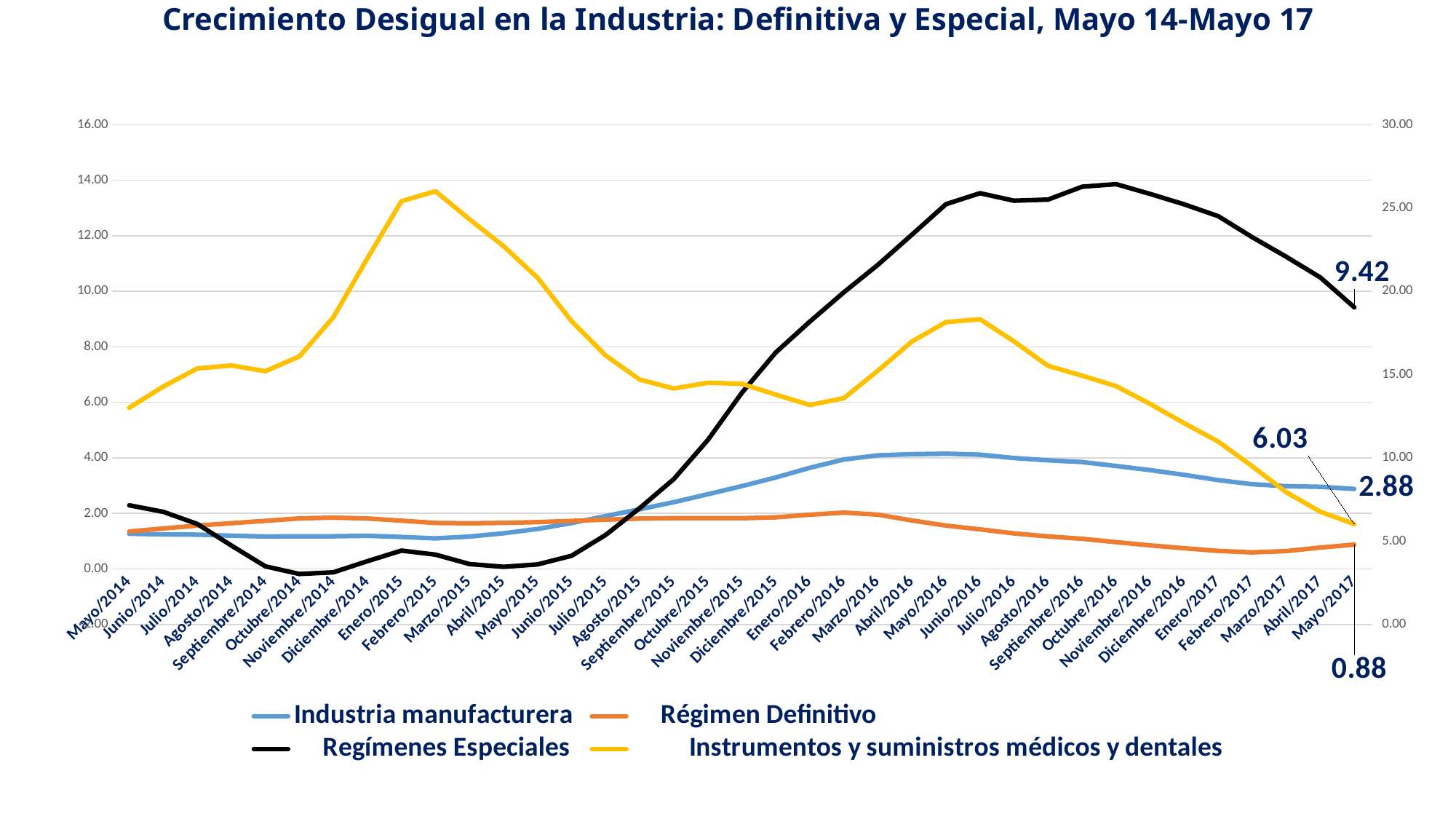
What is the value for Regímenes Especiales in Mayo/2017? 9.42 What is the difference between the Mayo/2017 values for Industria manufacturera and Régimen Definitivo? 2.00 In Mayo/2017, which is larger: Regímenes Especiales or Régimen Definitivo? Regímenes Especiales How many series does the legend list? 4 What is the title of the chart? Crecimiento Desigual en la Industria: Definitiva y Especial, Mayo 14-Mayo 17 What is the difference between the Mayo/2017 values for Regímenes Especiales and Industria manufacturera? 6.54 Is the value for Regímenes Especiales in Junio/2016 greater or less than 12.00 on the left axis? greater What is the value for Industria manufacturera in Mayo/2017? 2.88 What is the value for Instrumentos y suministros médicos y dentales in Mayo/2017? 6.03 What kind of chart is shown on the slide? line chart Does the Regímenes Especiales line rise or fall from Octubre/2016 to Mayo/2017? fall What is the value for Régimen Definitivo in Mayo/2017? 0.88